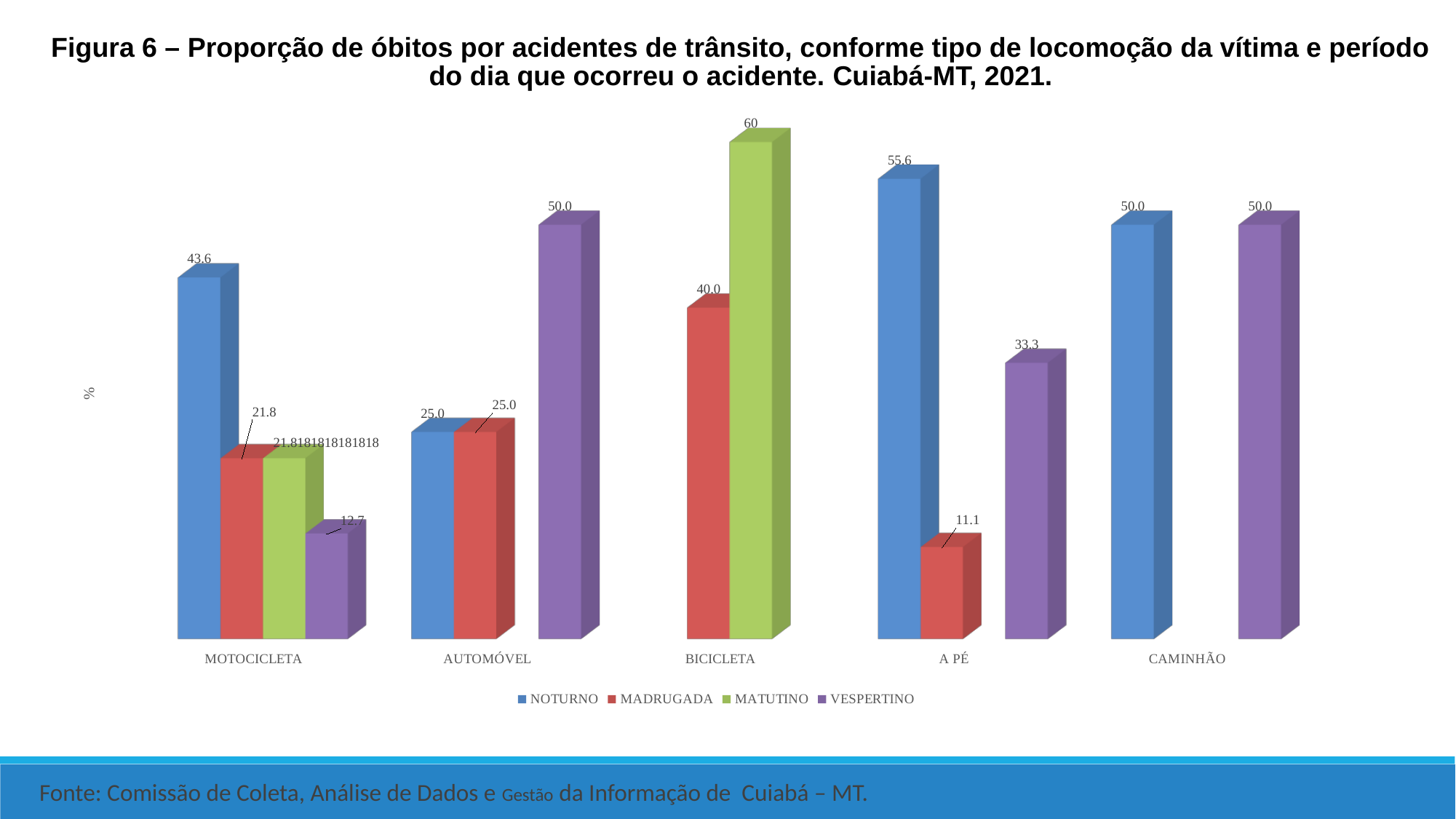
How many categories of locomotion are shown on the x axis? 5 What is the MATUTINO value for BICICLETA? 60 What type of chart is shown on the slide? bar chart Which category has the lowest VESPERTINO value? MOTOCICLETA What is the VESPERTINO value for A PÉ? 33.3 What is the difference between the NOTURNO and MADRUGADA values for A PÉ? 44.5 What is the MADRUGADA value for A PÉ? 11.1 Which series is shown in green in the legend? MATUTINO What is the NOTURNO value for MOTOCICLETA? 43.6 Which category has the highest NOTURNO value? A PÉ How many series does the legend list? 4 Which is larger for BICICLETA, the MADRUGADA value or the MATUTINO value? MATUTINO